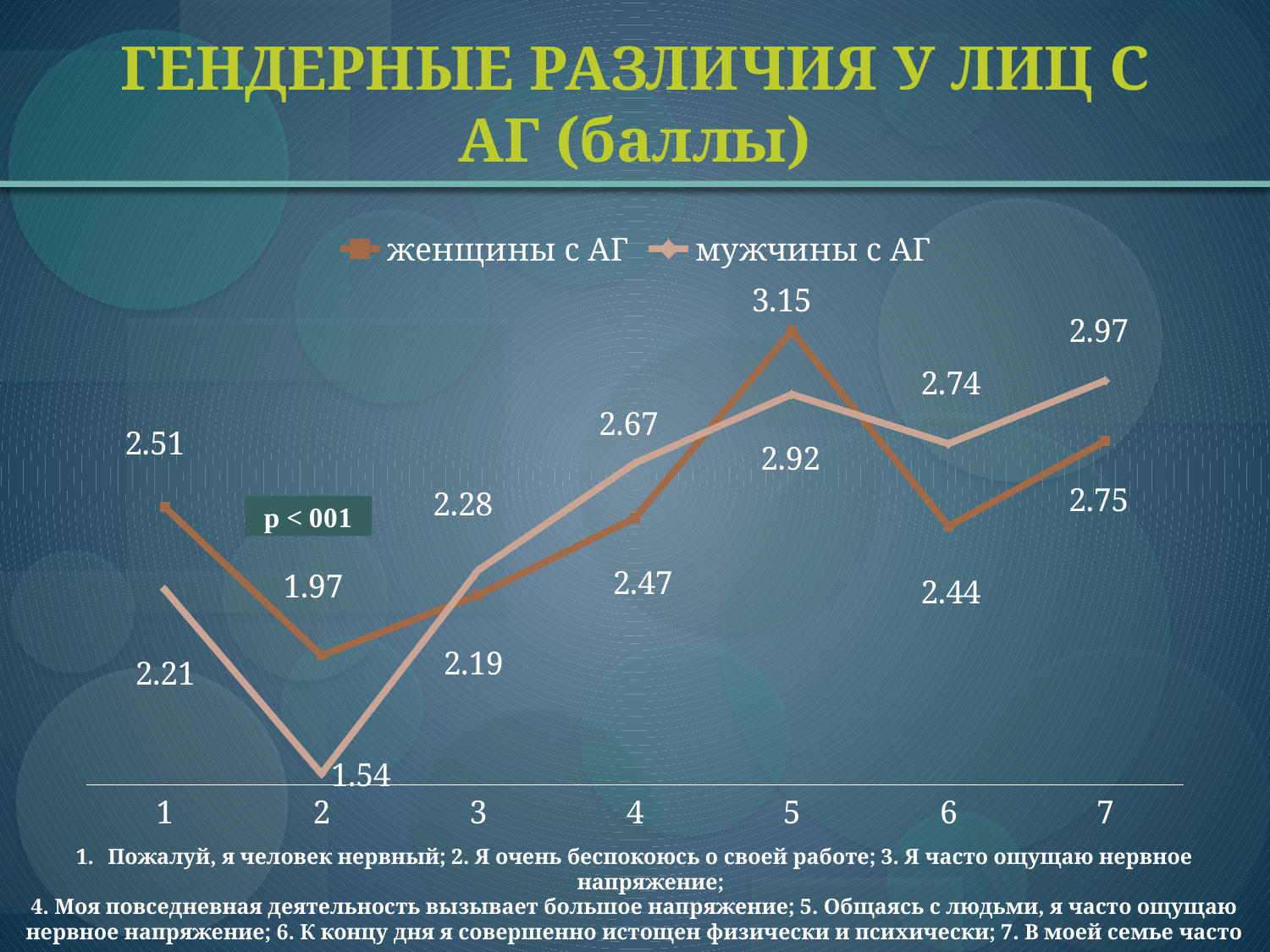
How many categories are plotted along the x axis? 7 What kind of chart is shown on the slide? line chart What is the value for 'женщины с АГ' at category 1? 2.51 At which category does the 'мужчины с АГ' series have its lowest value? 2 Which series has the larger value at category 7? мужчины с АГ What is the value for 'женщины с АГ' at category 5? 3.15 How many series does the legend list? 2 What is the difference between 'женщины с АГ' and 'мужчины с АГ' at category 5? 0.23 What is the value for 'мужчины с АГ' at category 7? 2.97 At which category does the 'женщины с АГ' series reach its highest value? 5 What are the two series named in the legend? женщины с АГ, мужчины с АГ What is the value for 'мужчины с АГ' at category 2? 1.54